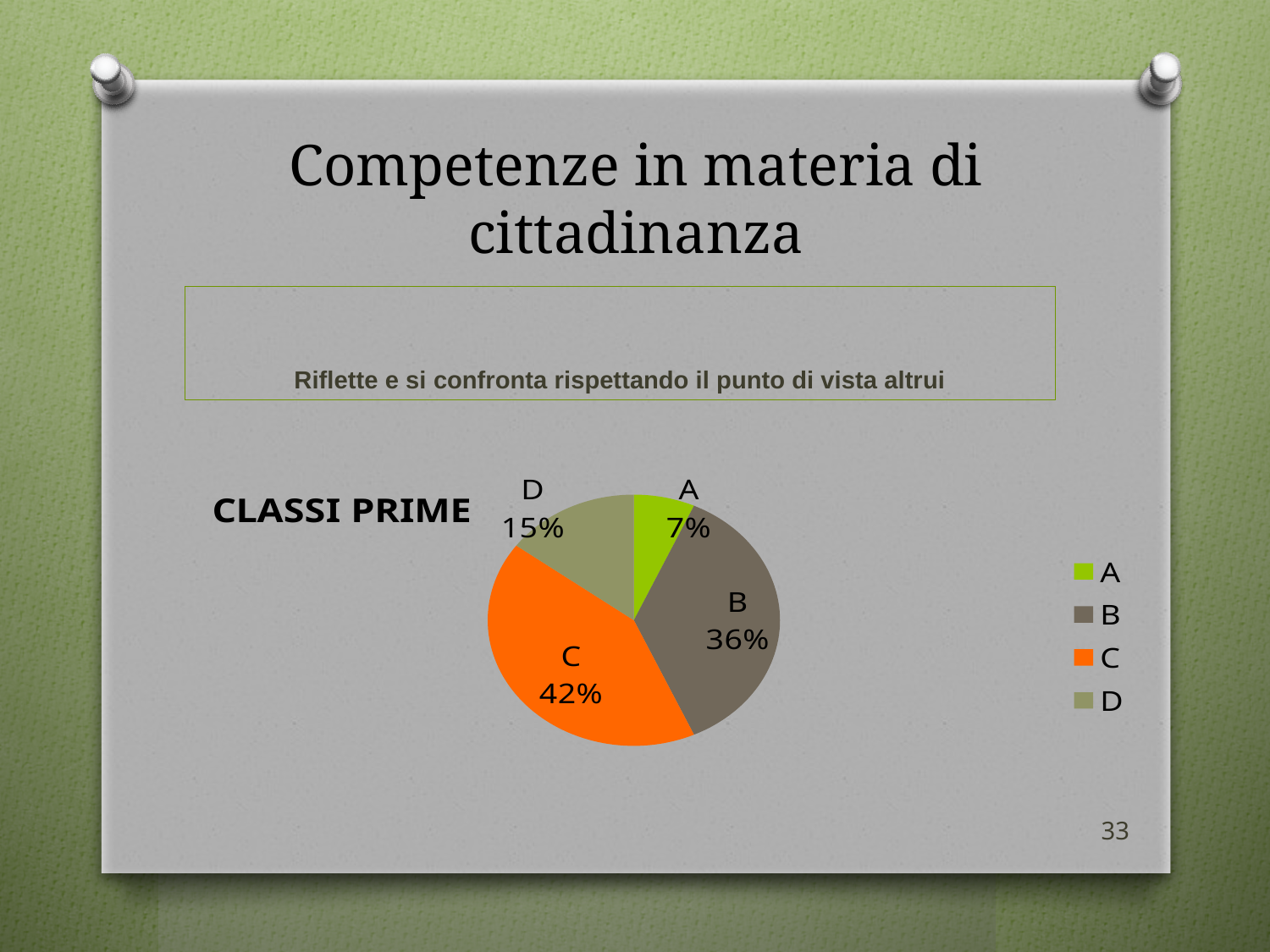
What percentage does slice B represent? 36% What percentage does slice D represent? 15% How many entries does the legend list? 4 Which category has the smallest share of the pie? A What percentage does slice C represent? 42% What percentage does slice A represent? 7% Which is larger, the share for B or the share for D? B What is the difference in percentage points between slice C and slice B? 6 How many slices does the pie chart have? 4 What colour is the slice for category C? orange What type of chart is shown on the slide? pie chart Which category has the largest share of the pie? C